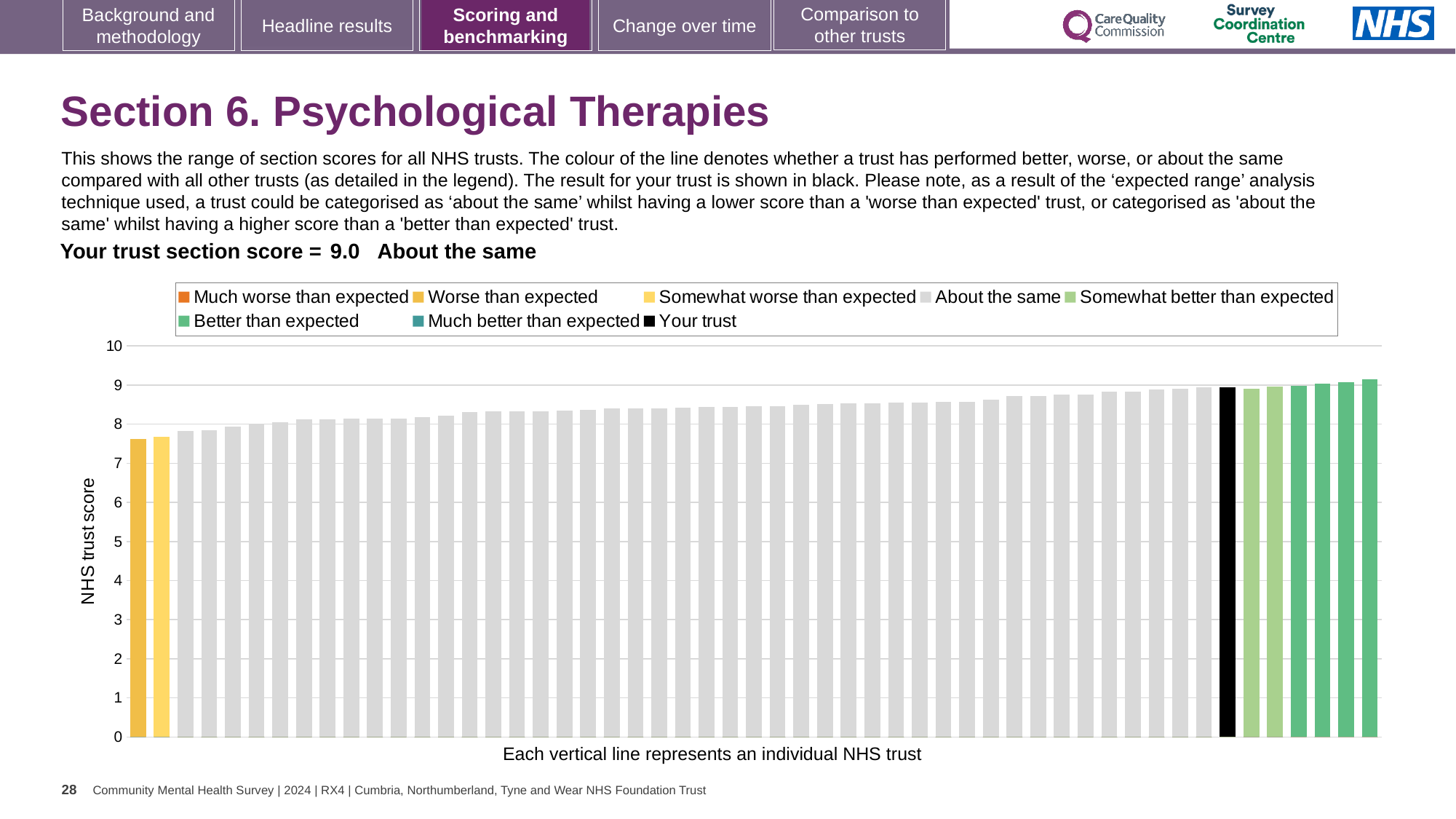
How many bars are coloured as 'Better than expected' (the darker green)? 4 What is the section score for your trust? 9.0 Is the value of the highest bar in the chart greater or less than 9? greater Is the value of the lowest bar in the chart greater or less than 7? greater Which is larger: your trust's score or the score of the leftmost (lowest) trust? your trust's score Is the value of the lowest bar in the chart greater or less than 8? less What kind of chart is shown on the slide? bar chart What colour is the bar representing your trust? black How many entries does the chart legend list? 8 Which performance category is your trust's section score placed in? About the same Do the bar values rise or fall from left to right along the x axis? rise